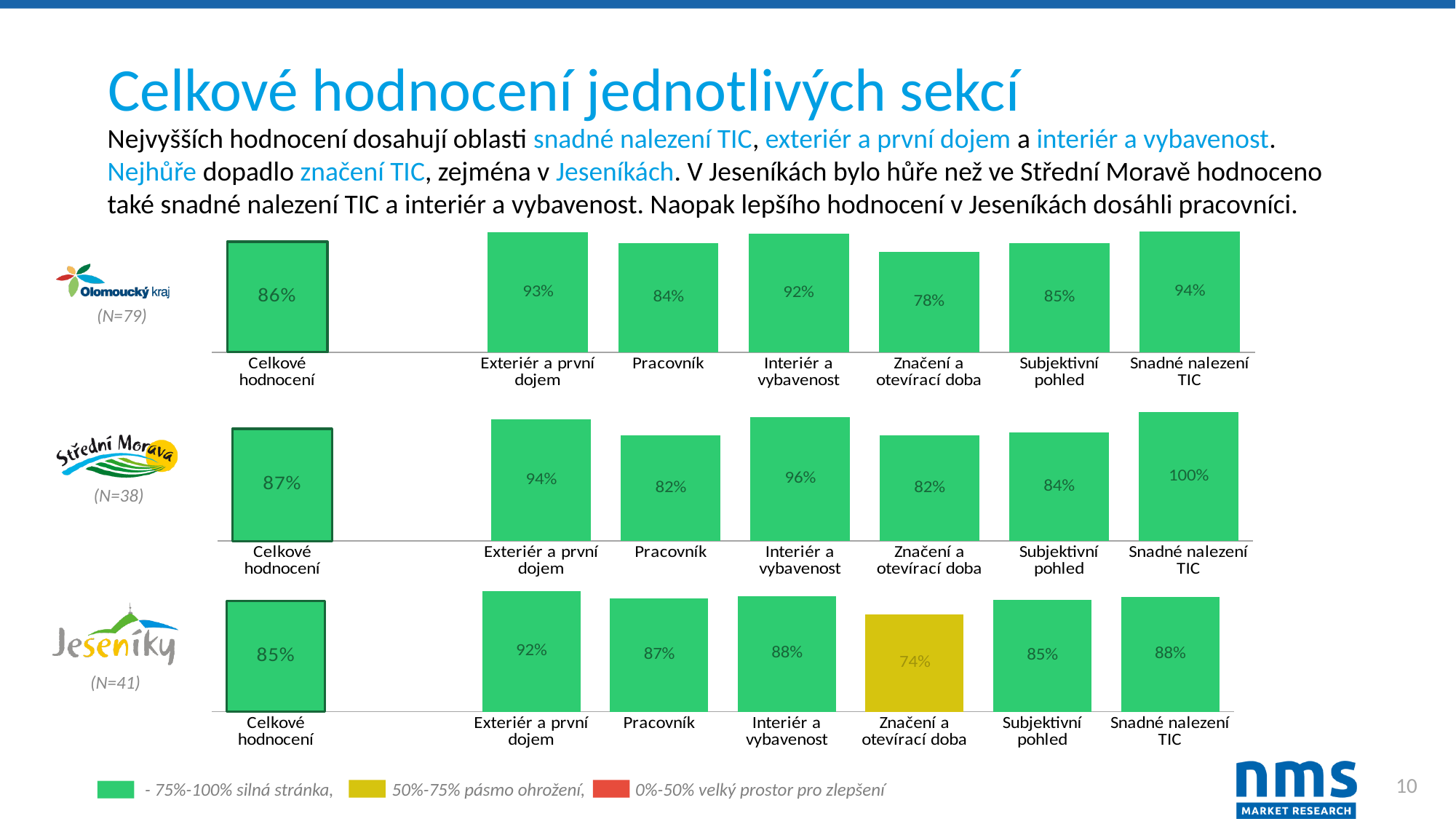
What is the difference between the Celkové hodnocení values in the middle chart (Střední Morava) and the top chart (Olomoucký kraj)? 1% In the bottom chart (Jeseníky), what is the value for Pracovník? 87% In the bottom chart (Jeseníky), which category has the lowest value? Značení a otevírací doba How many categories are plotted in the top chart (Olomoucký kraj)? 7 In the bottom chart (Jeseníky), which bar is coloured yellow instead of green? Značení a otevírací doba In the bottom chart (Jeseníky), which is larger: Exteriér a první dojem or Interiér a vybavenost? Exteriér a první dojem What kind of chart is used for Střední Morava (middle chart)? Bar chart In the middle chart (Střední Morava), what is the value for Snadné nalezení TIC? 100% In the bottom chart (Jeseníky), what is the value for Celkové hodnocení? 85% In the top chart (Olomoucký kraj), what is the value for Značení a otevírací doba? 78% In the top chart (Olomoucký kraj), which category has the highest value? Snadné nalezení TIC In the middle chart (Střední Morava), what is the difference between Interiér a vybavenost and Pracovník? 14%